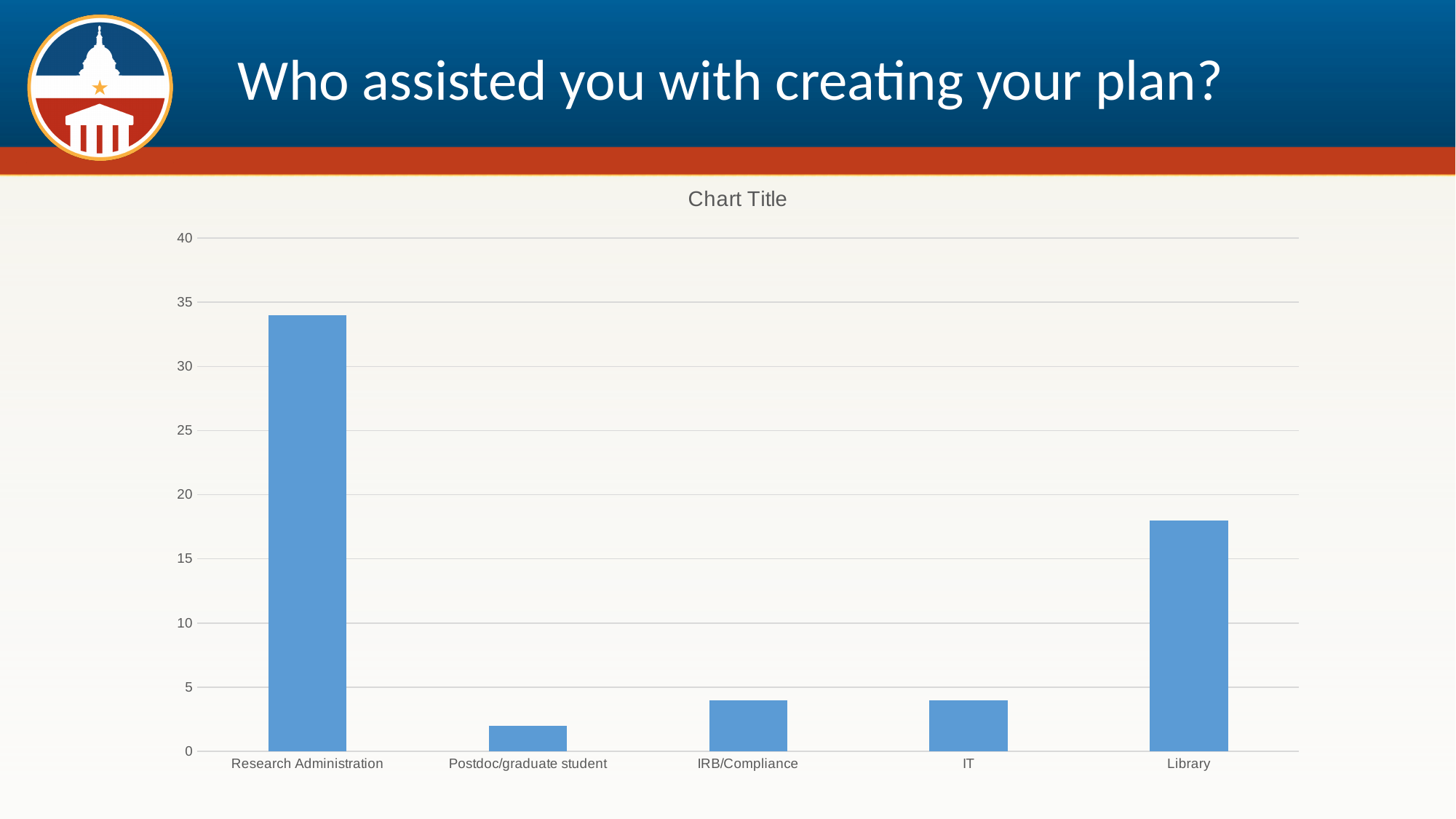
Is the value for Library greater or less than 15? greater Is the value for Library greater or less than 20? less How many categories are shown on the x axis of the chart? 5 What is the title printed above the chart? Chart Title Is the value for Postdoc/graduate student greater or less than 5? less Which is larger, the value for Library or the value for IT? Library Which category has the lowest bar in the chart? Postdoc/graduate student Which category has the highest bar in the chart? Research Administration What kind of chart is shown on the slide? bar chart